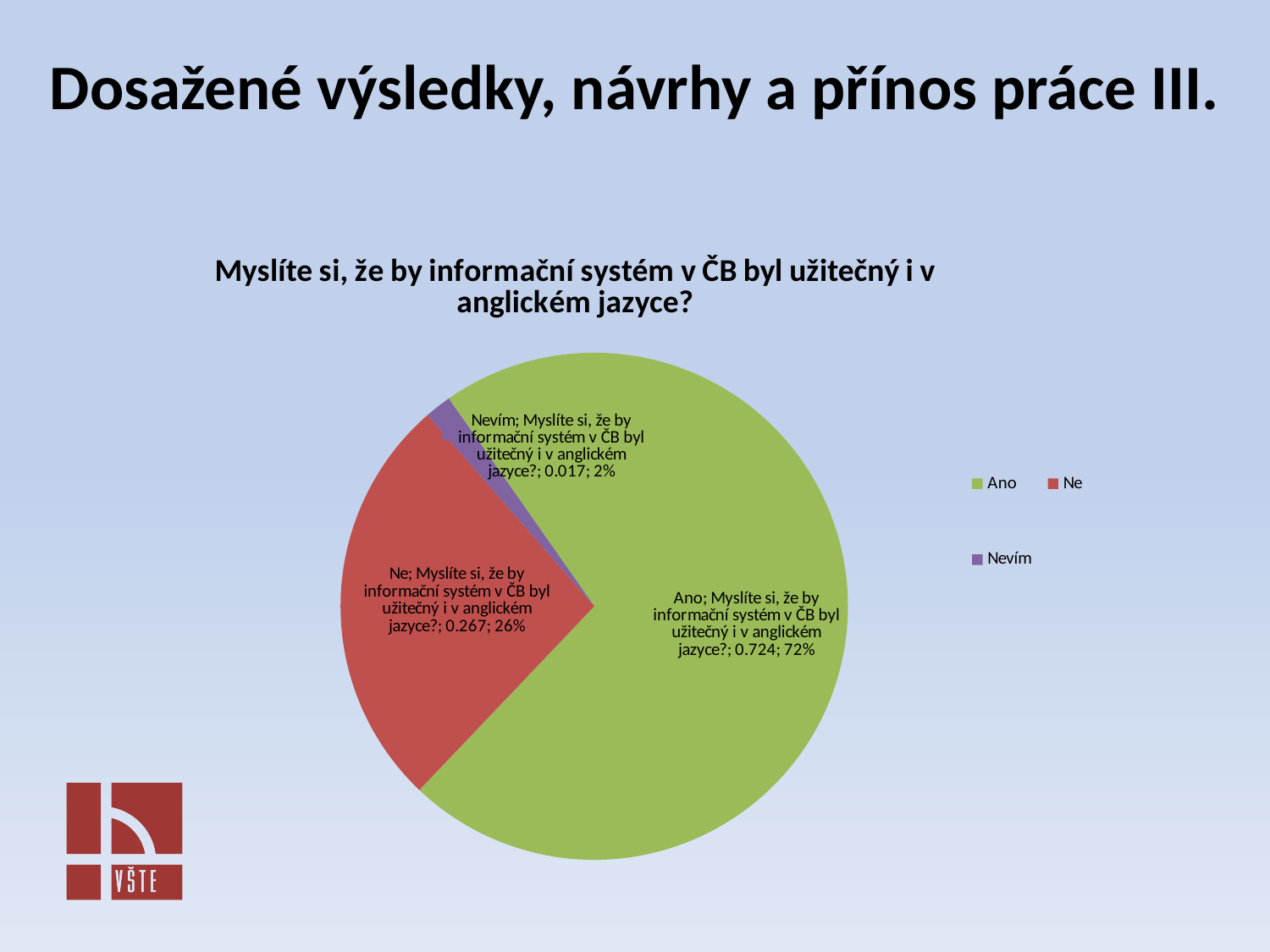
Which category has the smallest slice? Nevím What percentage share does the 'Nevím' slice have? 2% What percentage share does the 'Ne' slice have? 26% Which category has the largest slice? Ano What is the difference in percentage points between the 'Ano' and 'Ne' slices? 46% What value is printed for the 'Ano' slice? 0.724 What colour is the 'Ne' slice? red What kind of chart is shown on the slide? pie chart How many slices does the pie chart have? 3 What value is printed for the 'Nevím' slice? 0.017 What percentage share does the 'Ano' slice have? 72% What value is printed for the 'Ne' slice? 0.267